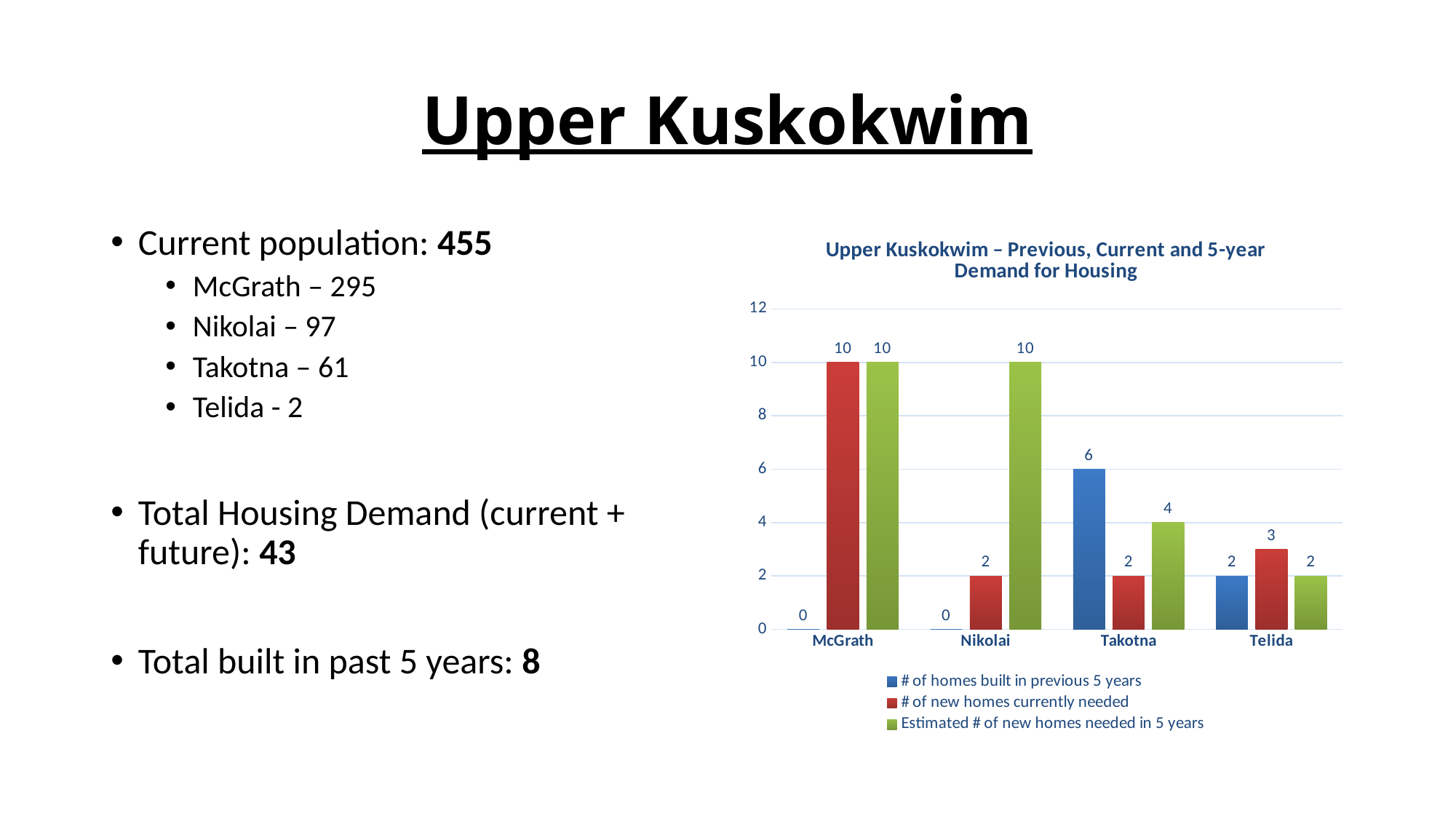
Which community has the highest number of homes built in the previous 5 years? Takotna How many communities are shown on the x axis of the chart? 4 What is the estimated number of new homes needed in 5 years for Nikolai? 10 What is the title of the chart? Upper Kuskokwim – Previous, Current and 5-year Demand for Housing How many series does the chart legend list? 3 What is the difference between the estimated number of new homes needed in 5 years for Nikolai and for Takotna? 6 Which community has the lowest estimated number of new homes needed in 5 years? Telida How many homes were built in the previous 5 years in Takotna? 6 Which is larger for Takotna: the number of homes built in the previous 5 years or the estimated number of new homes needed in 5 years? # of homes built in previous 5 years What kind of chart is shown on the slide? bar chart What is the number of new homes currently needed in McGrath? 10 What is the number of new homes currently needed in Telida? 3